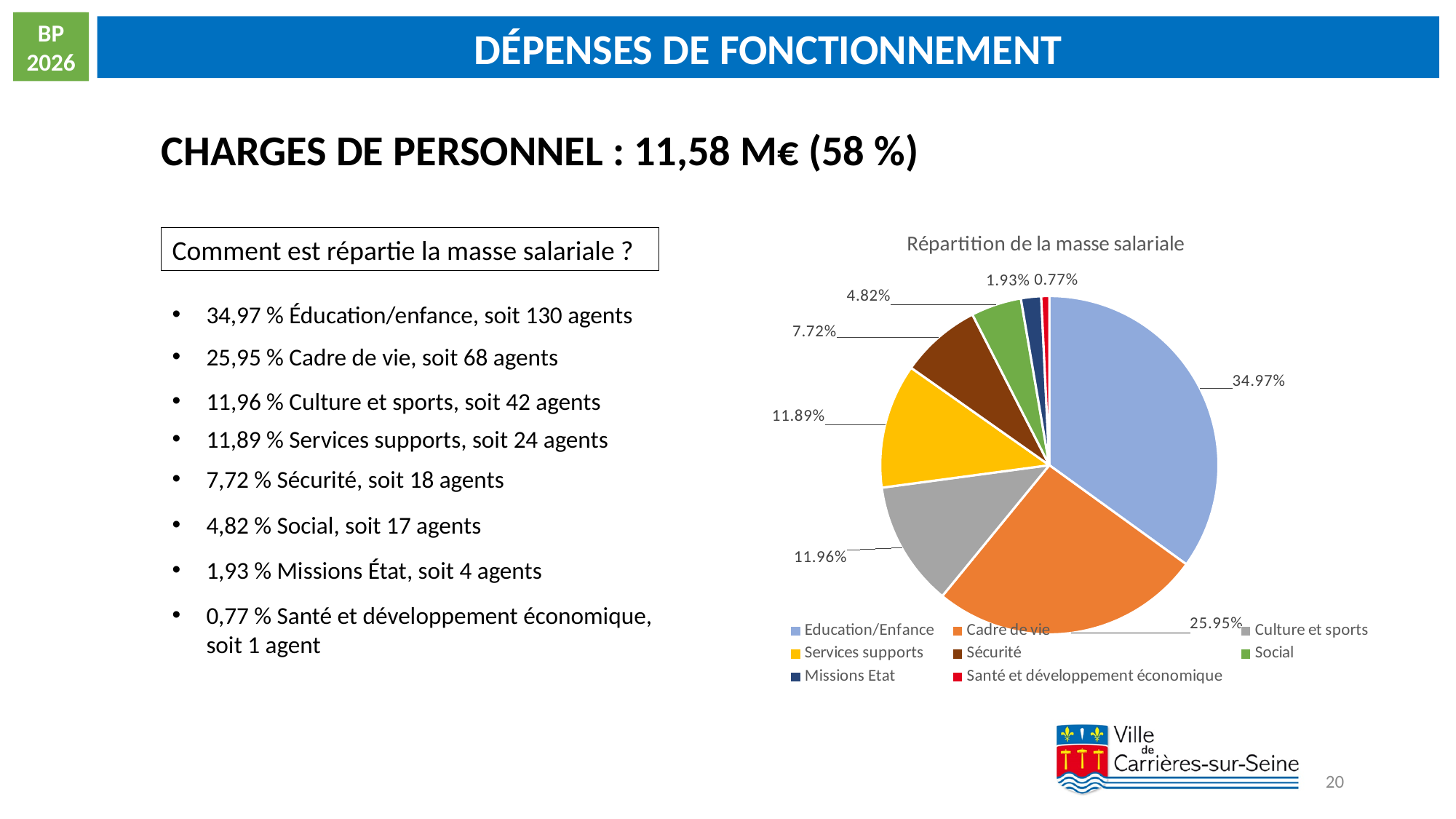
Which category has the smallest slice of the pie? Santé et développement économique How many categories does the pie chart have? 8 What share of the pie does Education/Enfance represent? 34.97% What colour is the Services supports slice? yellow Which category has the largest slice of the pie? Education/Enfance What is the value shown for Sécurité? 7.72% Which is larger, the share for Social or the share for Missions Etat? Social What is the difference between the shares of Education/Enfance and Cadre de vie? 9.02% What kind of chart is shown on the slide? pie chart What share of the pie does Cadre de vie represent? 25.95% What is the title of the chart? Répartition de la masse salariale What is the value shown for Santé et développement économique? 0.77%